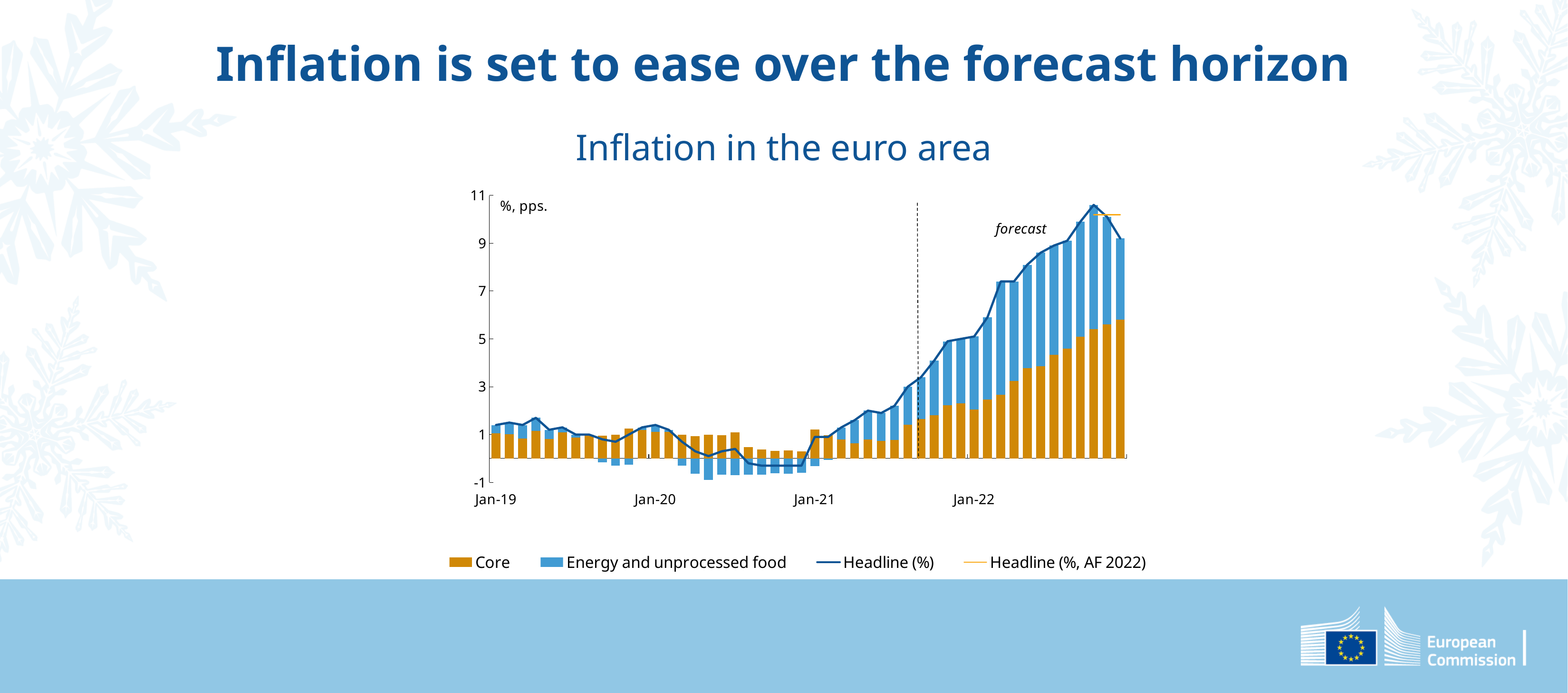
Which legend entry is shown in orange/gold bars? Core What kind of chart is shown on the slide? Bar chart with line series (stacked bars and lines) Is the Energy and unprocessed food contribution at Jan-22 greater or less than 1? greater Among the labelled x-axis dates Jan-19, Jan-20, Jan-21 and Jan-22, at which is the Headline (%) value highest? Jan-22 Is the Headline (%) value at Jan-20 greater or less than 1? greater Is the peak Headline (%) value in the forecast period greater or less than 9? greater Does the Headline (%) line rise or fall between Jan-21 and Jan-22? rise How many series does the legend list? 4 What is the title of the chart? Inflation in the euro area Which is larger, the Headline (%) value at Jan-22 or at Jan-21? Jan-22